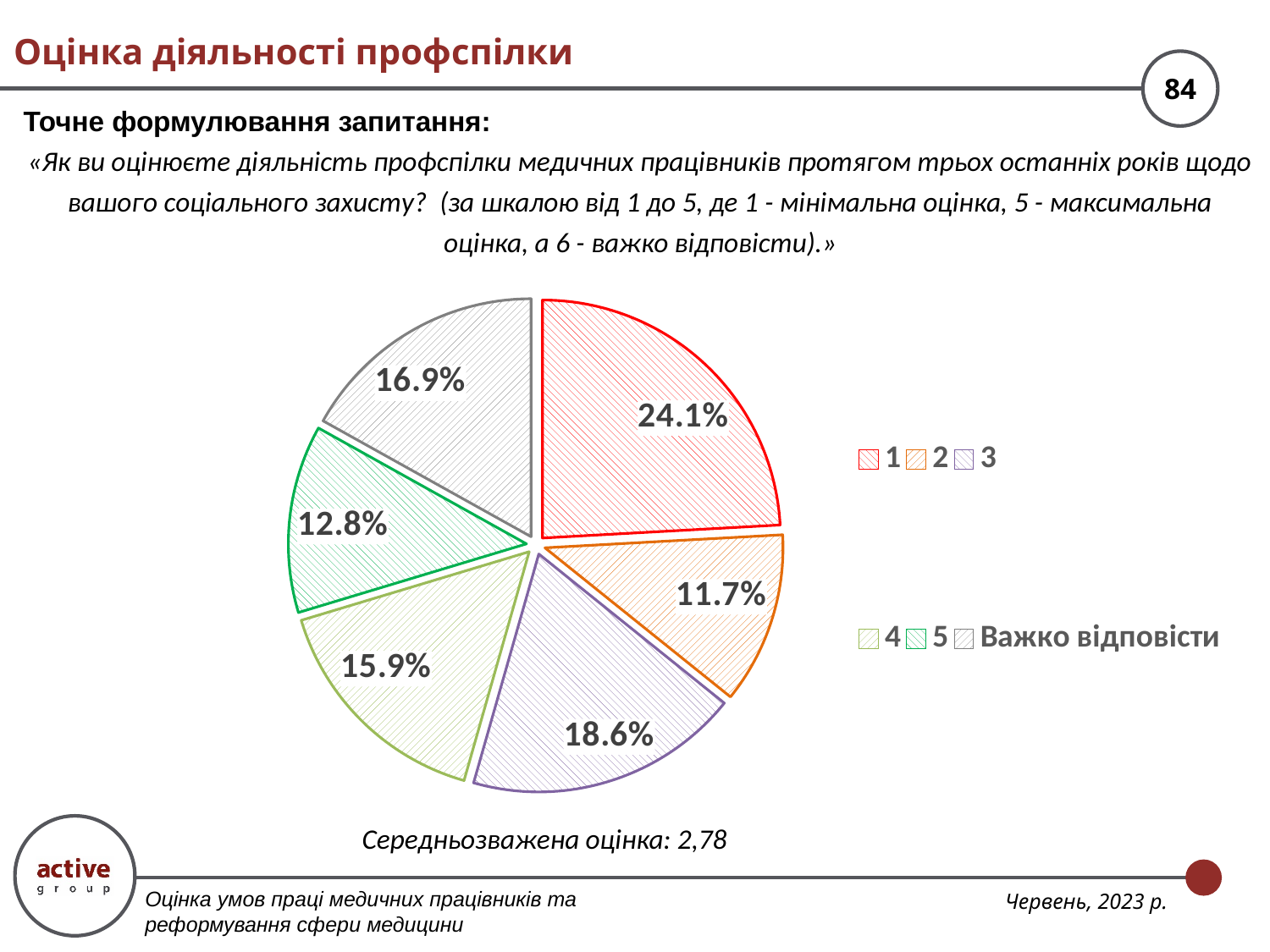
What is the difference between the share for rating 1 and the share for rating 2? 12.4% Which rating category has the largest slice of the pie? 1 What type of chart is shown on the slide? pie chart What share of respondents answered 'Важко відповісти'? 16.9% What share of respondents gave a rating of 3? 18.6% How many categories does the legend list? 6 What share of respondents gave a rating of 5? 12.8% Which is larger: the share for rating 3 or the share for rating 4? 3 What share of respondents gave a rating of 1? 24.1% Which rating category has the smallest slice of the pie? 2 What share of respondents gave a rating of 2? 11.7% What share of respondents gave a rating of 4? 15.9%